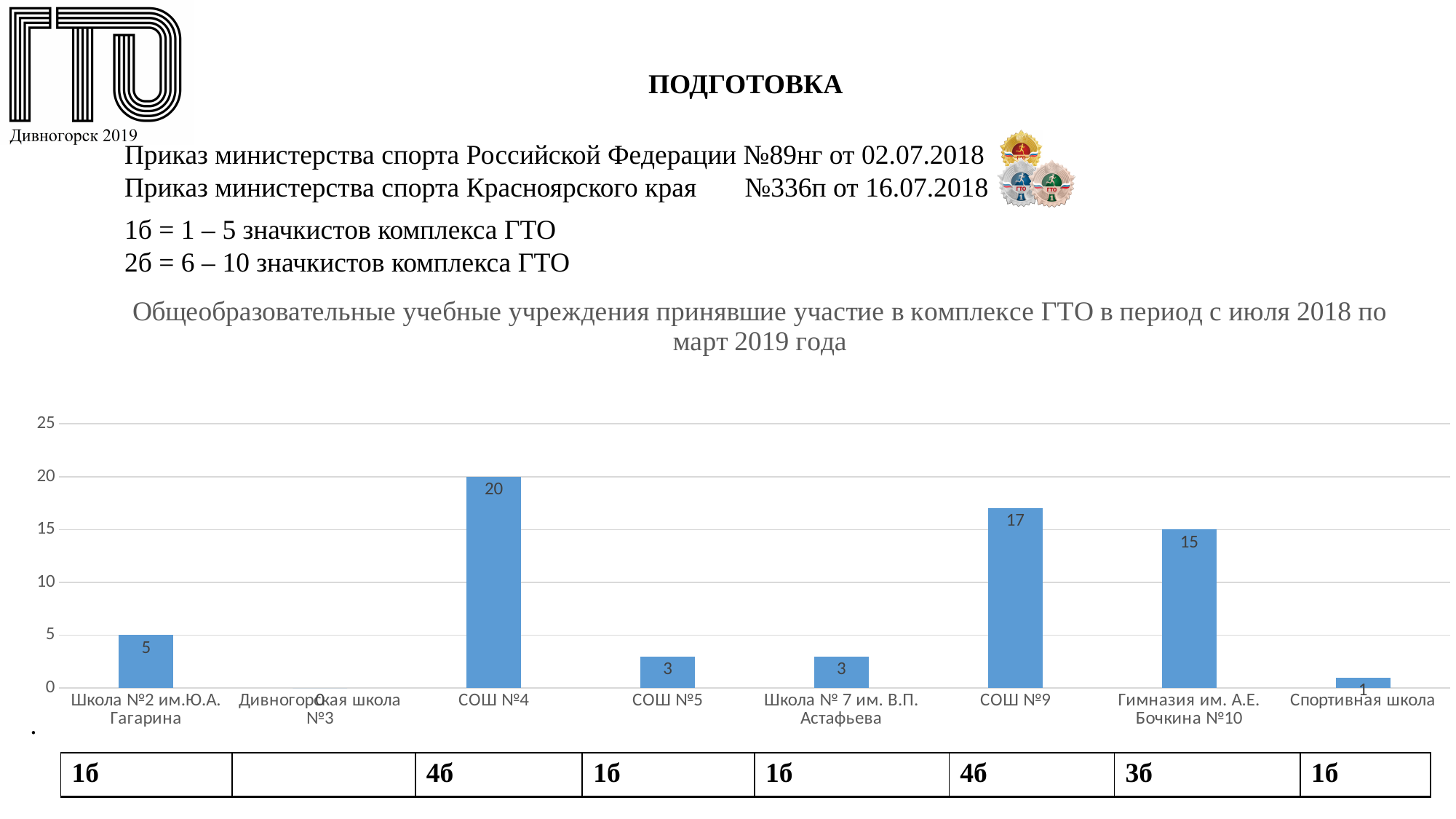
What type of chart is shown on the slide? bar chart What is the value for СОШ №9? 17 How many categories are shown on the x axis of the chart? 8 What is the value for Школа №2 им.Ю.А. Гагарина? 5 Which is larger, the value for Гимназия им. А.Е. Бочкина №10 or the value for Школа №2 им.Ю.А. Гагарина? Гимназия им. А.Е. Бочкина №10 Which category has the lowest value? Дивногорская школа №3 What is the value for СОШ №5? 3 What is the value for СОШ №4? 20 What is the difference between the values for СОШ №4 and СОШ №9? 3 What is the value for Спортивная школа? 1 What is the value for Гимназия им. А.Е. Бочкина №10? 15 Which category has the highest value? СОШ №4